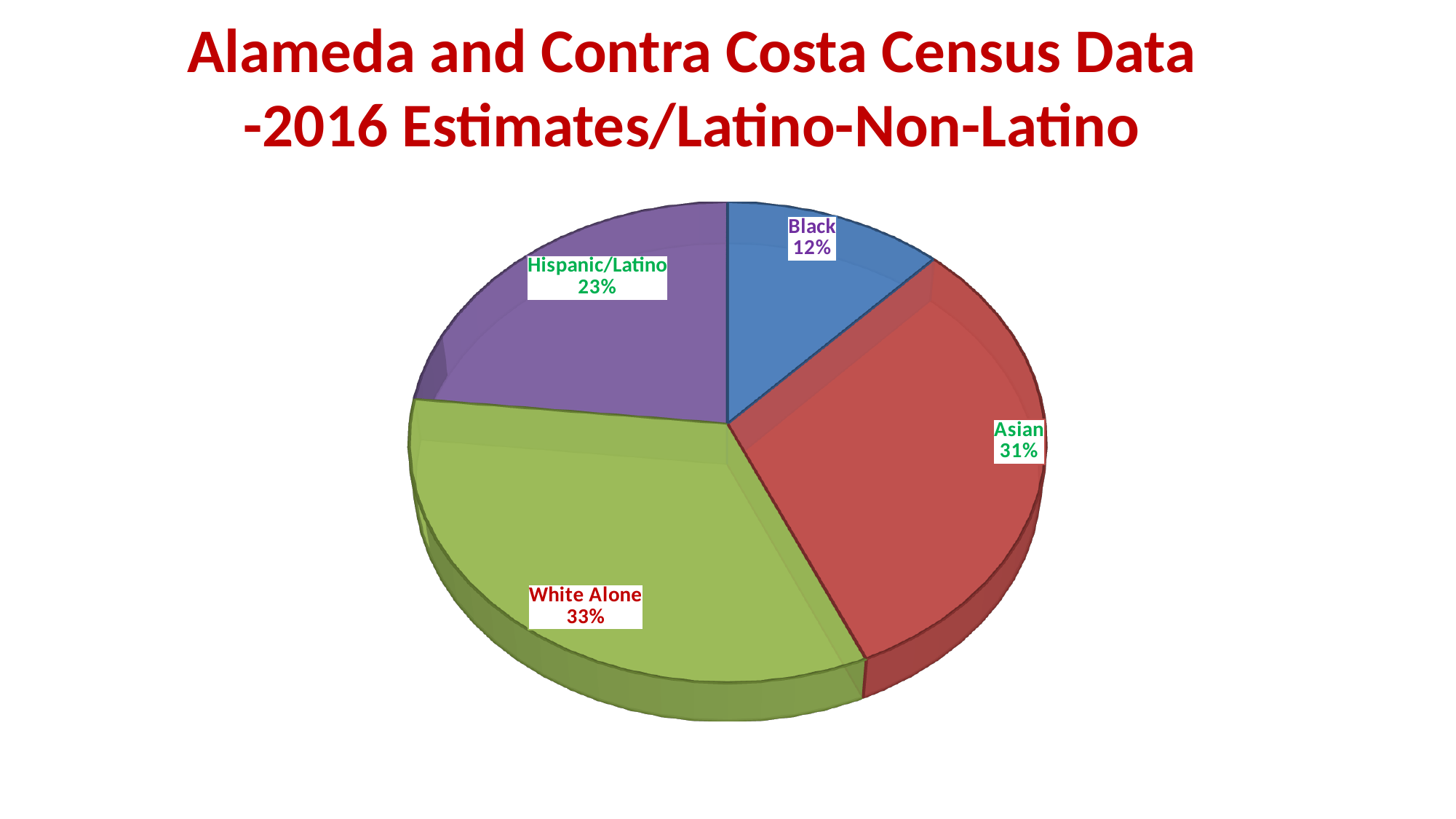
Which category has the smallest slice of the pie? Black How many slices does the pie chart have? 4 Which is larger, the Hispanic/Latino slice or the Black slice? Hispanic/Latino What share of the pie does the Asian slice represent? 31% What is the difference in percentage points between the Asian and Hispanic/Latino slices? 8 What percentage is shown for the Hispanic/Latino slice? 23% Which category has the largest slice of the pie? White Alone What kind of chart is shown on the slide? Pie chart What share of the pie does the White Alone slice represent? 33% What percentage is shown for the Black slice? 12% What is the difference in percentage points between the White Alone and Black slices? 21 What is the title of the chart on the slide? Alameda and Contra Costa Census Data -2016 Estimates/Latino-Non-Latino